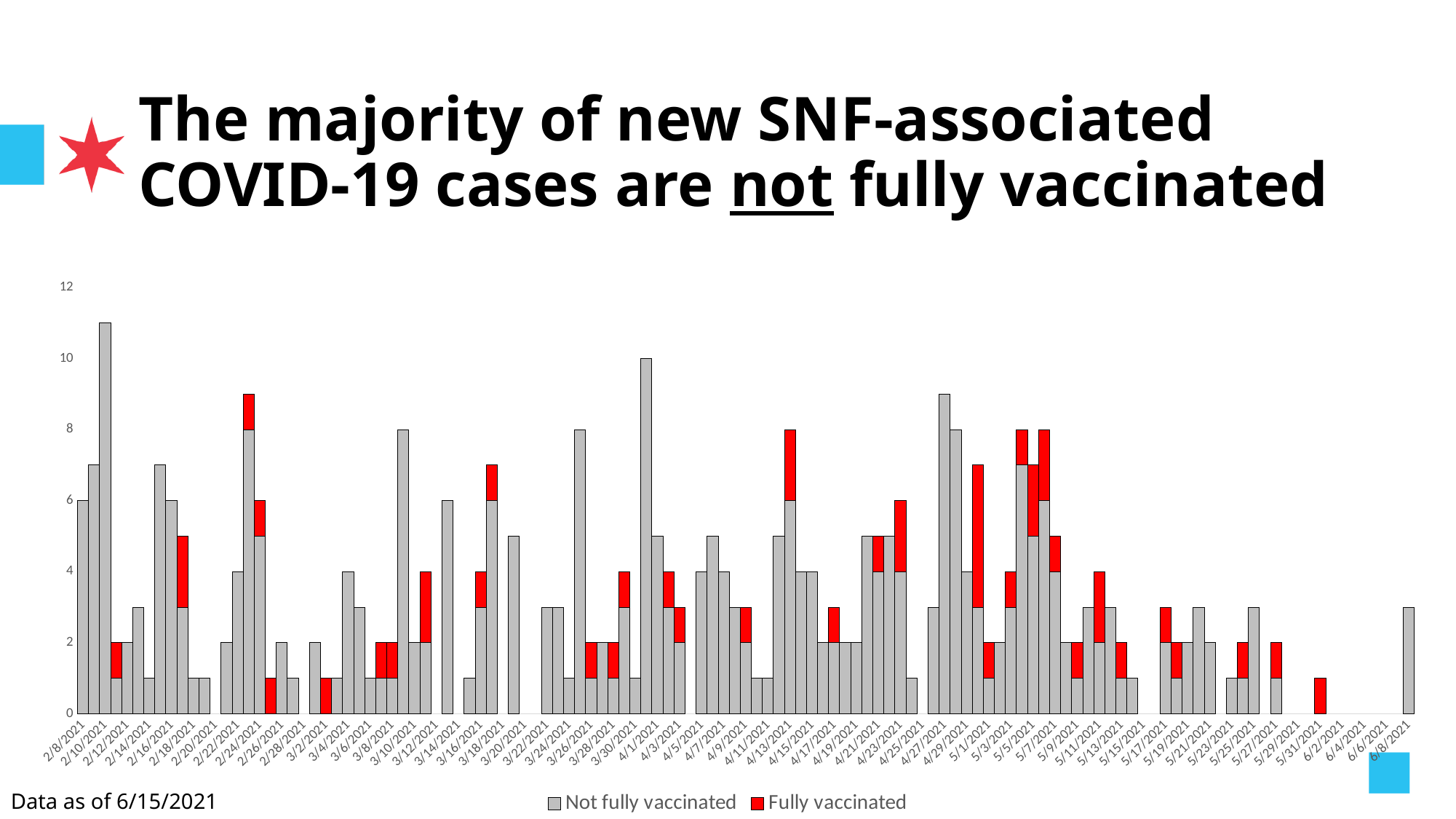
What is the highest value shown on the vertical axis? 12 Is the total value for 2/10/2021 greater or less than 10? greater Which date has the tallest bar in the chart? 2/10/2021 Is the total value for 4/1/2021 greater or less than 8? less Which is larger, the total for 2/10/2021 or the total for 3/10/2021? 2/10/2021 Which colour represents the 'Fully vaccinated' series? Red As of what date is the data shown on the slide? 6/15/2021 How many series does the legend list? 2 Do the bar totals generally rise or fall from 5/7/2021 to 6/8/2021? fall What kind of chart is shown on the slide? Stacked bar chart